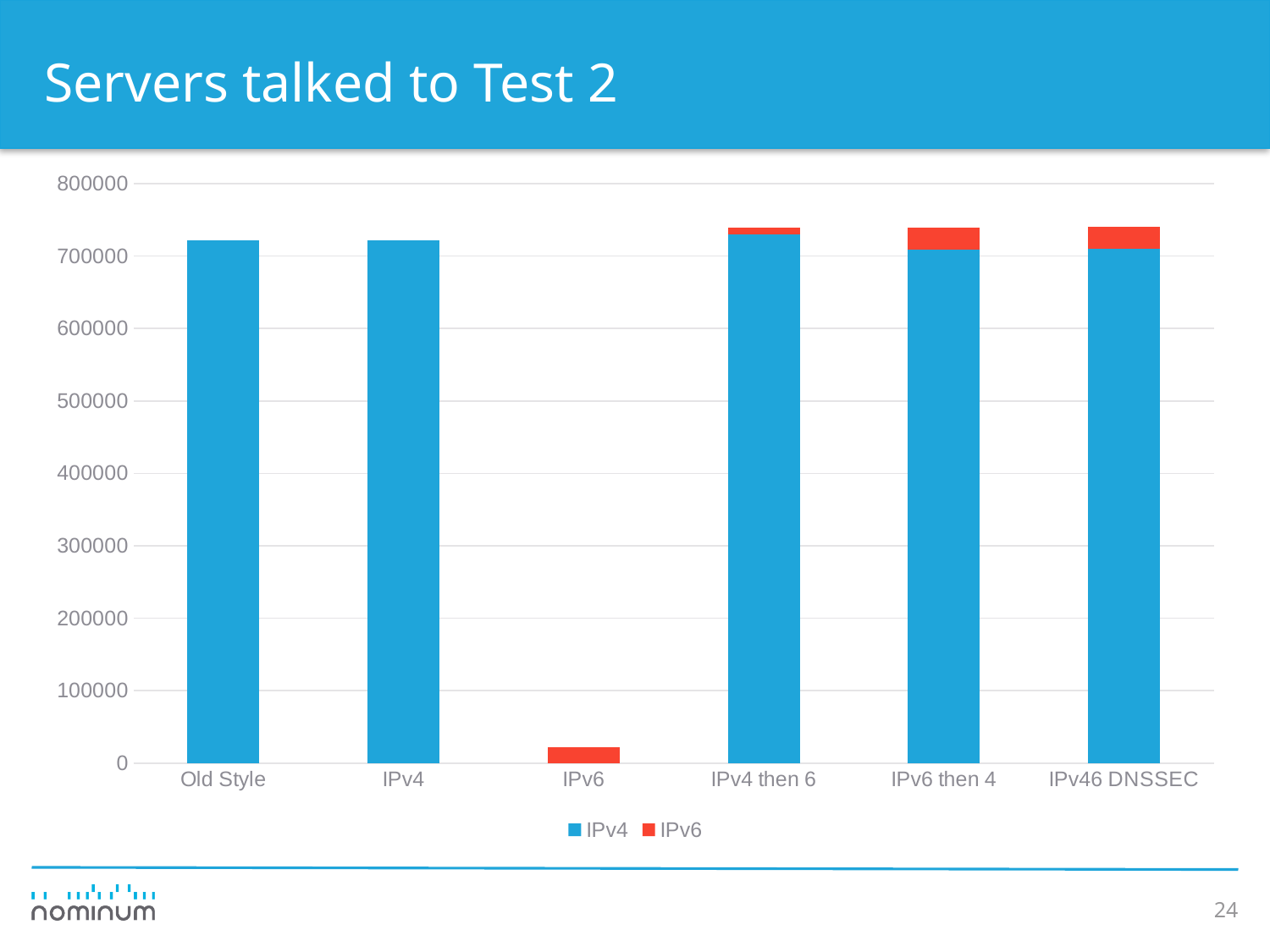
How many categories are shown along the x axis? 6 How many series does the legend list? 2 Is the IPv4 value for IPv6 then 4 greater or less than 600000? greater Is the IPv4 value for Old Style greater or less than 700000? greater Which category has the larger IPv6 segment, IPv4 then 6 or IPv6 then 4? IPv6 then 4 What kind of chart is shown on the slide? bar chart Is the total bar for IPv4 then 6 greater or less than 700000? greater Which is larger, the total for Old Style or the total for IPv6? Old Style Which colour represents the IPv6 series in the legend? red What is the title of the chart? Servers talked to Test 2 Which category has the lowest total bar? IPv6